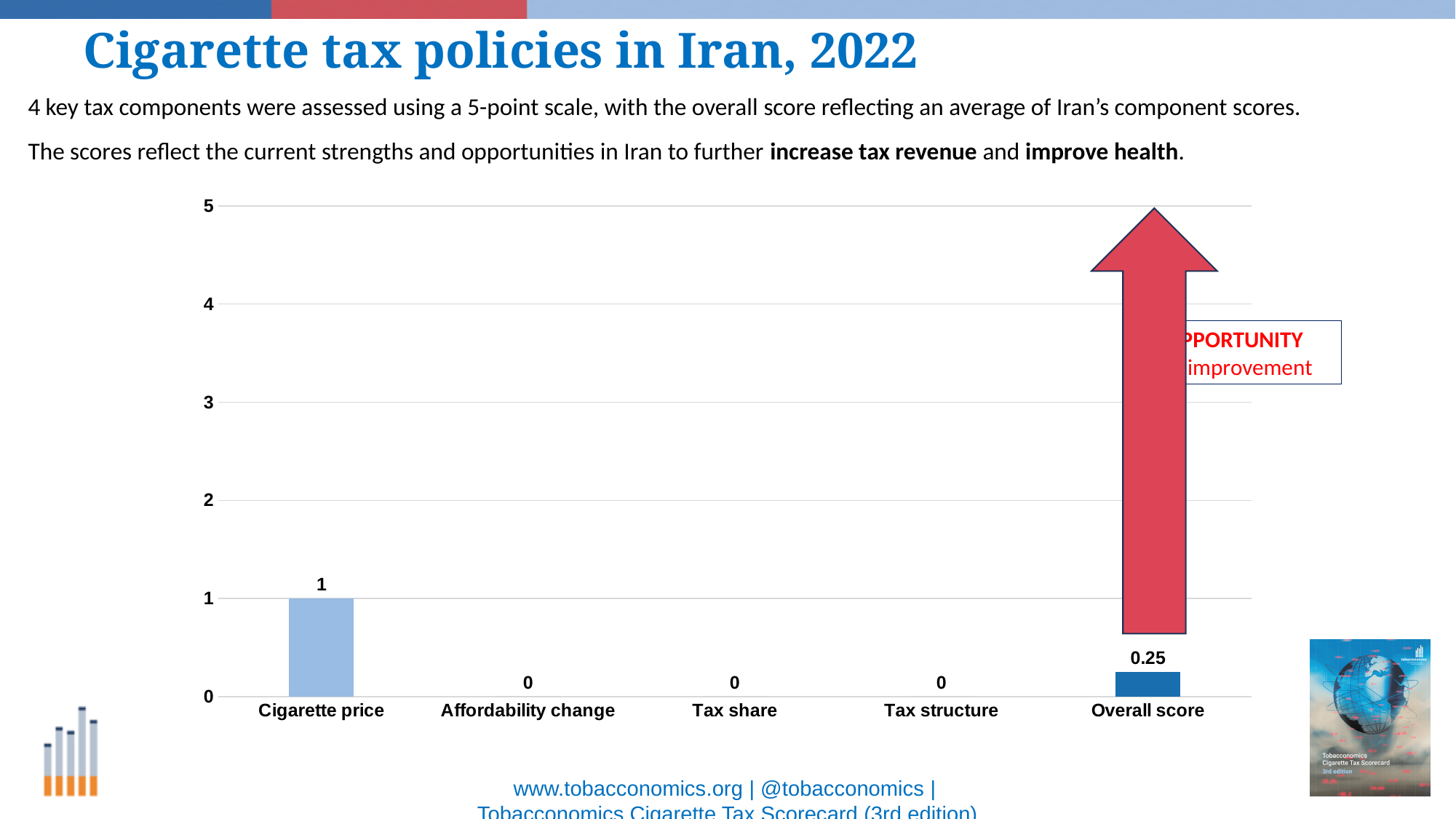
Which category has the highest value? Cigarette price How many categories have a value of 0? 3 What is the value for Affordability change? 0 What is the Overall score shown in the chart? 0.25 What is the difference between the Cigarette price score and the Overall score? 0.75 Is the value for Overall score greater or less than 1? less What is the value for Tax share? 0 Which is larger, the value for Cigarette price or the value for Tax structure? Cigarette price How many categories are shown on the x axis? 5 What is the maximum value shown on the y axis? 5 What kind of chart is shown on the slide? bar chart What is the value for Cigarette price? 1